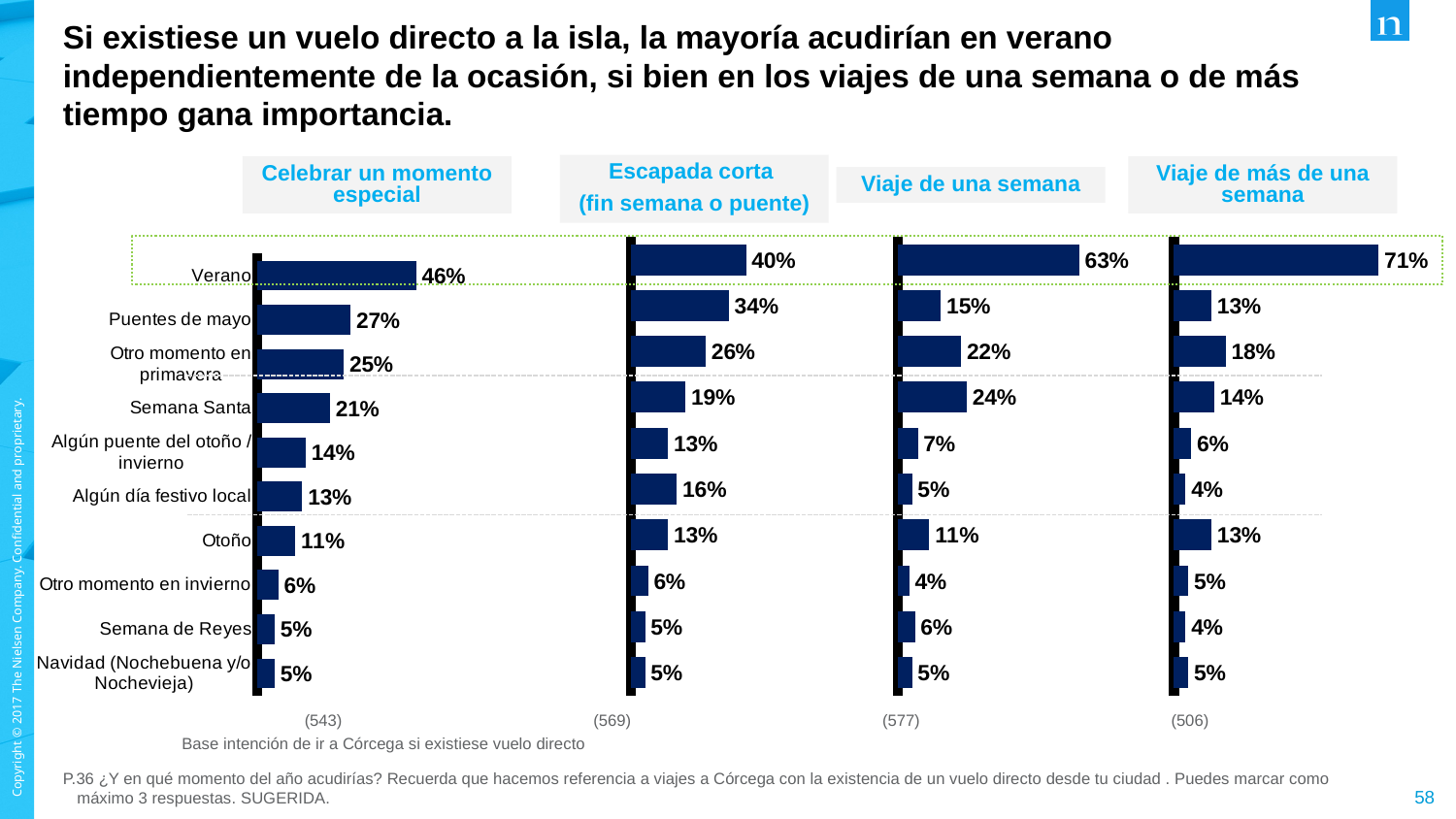
In the 'Viaje de una semana' chart, what is the value for Semana Santa? 24% How many categories are shown in the 'Celebrar un momento especial' chart? 10 What is the base size shown under the 'Viaje de una semana' chart? (577) In the 'Escapada corta (fin semana o puente)' chart, what is the value for Puentes de mayo? 34% In the 'Celebrar un momento especial' chart, what is the difference between Verano and Otoño? 35 percentage points What type of chart is used for 'Viaje de más de una semana'? Bar chart In the 'Viaje de más de una semana' chart, which category has the lowest value? Algún día festivo local and Semana de Reyes (4%) In the 'Celebrar un momento especial' chart, what is the value for Verano? 46% In the 'Viaje de una semana' chart, which category has the highest value? Verano In the 'Viaje de una semana' chart, what is the difference between Verano and Puentes de mayo? 48 percentage points In the 'Escapada corta (fin semana o puente)' chart, which is larger: Semana Santa or Algún día festivo local? Semana Santa In the 'Viaje de más de una semana' chart, what is the value for Verano? 71%